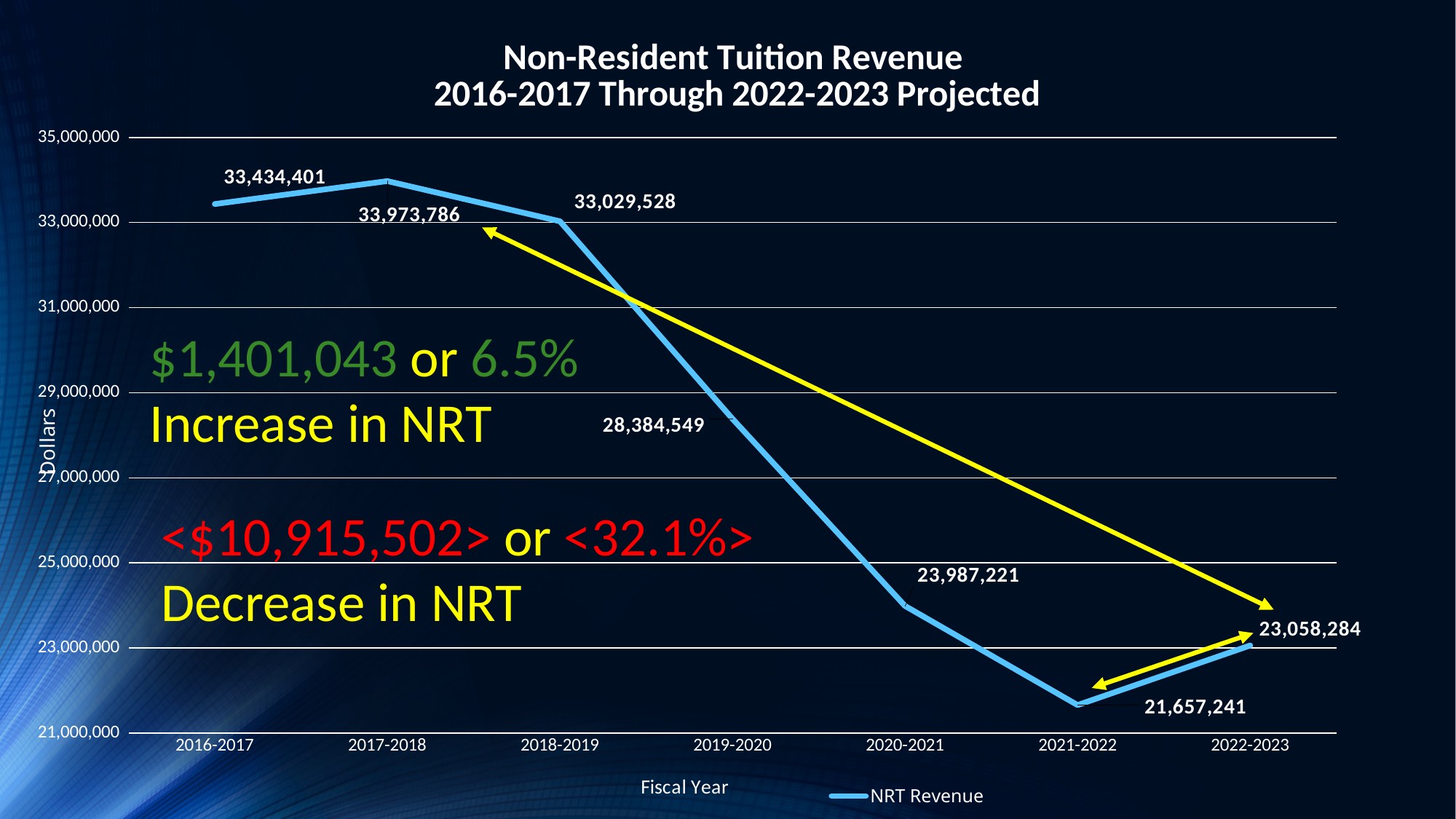
What is the NRT Revenue for 2017-2018? 33,973,786 What is the NRT Revenue for 2021-2022? 21,657,241 How many fiscal years are plotted on the chart? 7 Which fiscal year has higher NRT Revenue, 2020-2021 or 2022-2023? 2020-2021 What is the label of the x axis? Fiscal Year What type of chart is shown on the slide? line chart Is the NRT Revenue for 2019-2020 greater or less than 29,000,000? less Which fiscal year has the lowest NRT Revenue? 2021-2022 What is the difference in NRT Revenue between 2021-2022 and 2022-2023? 1,401,043 What is the difference in NRT Revenue between 2018-2019 and 2019-2020? 4,644,979 What is the NRT Revenue for 2019-2020? 28,384,549 Which fiscal year has the highest NRT Revenue? 2017-2018